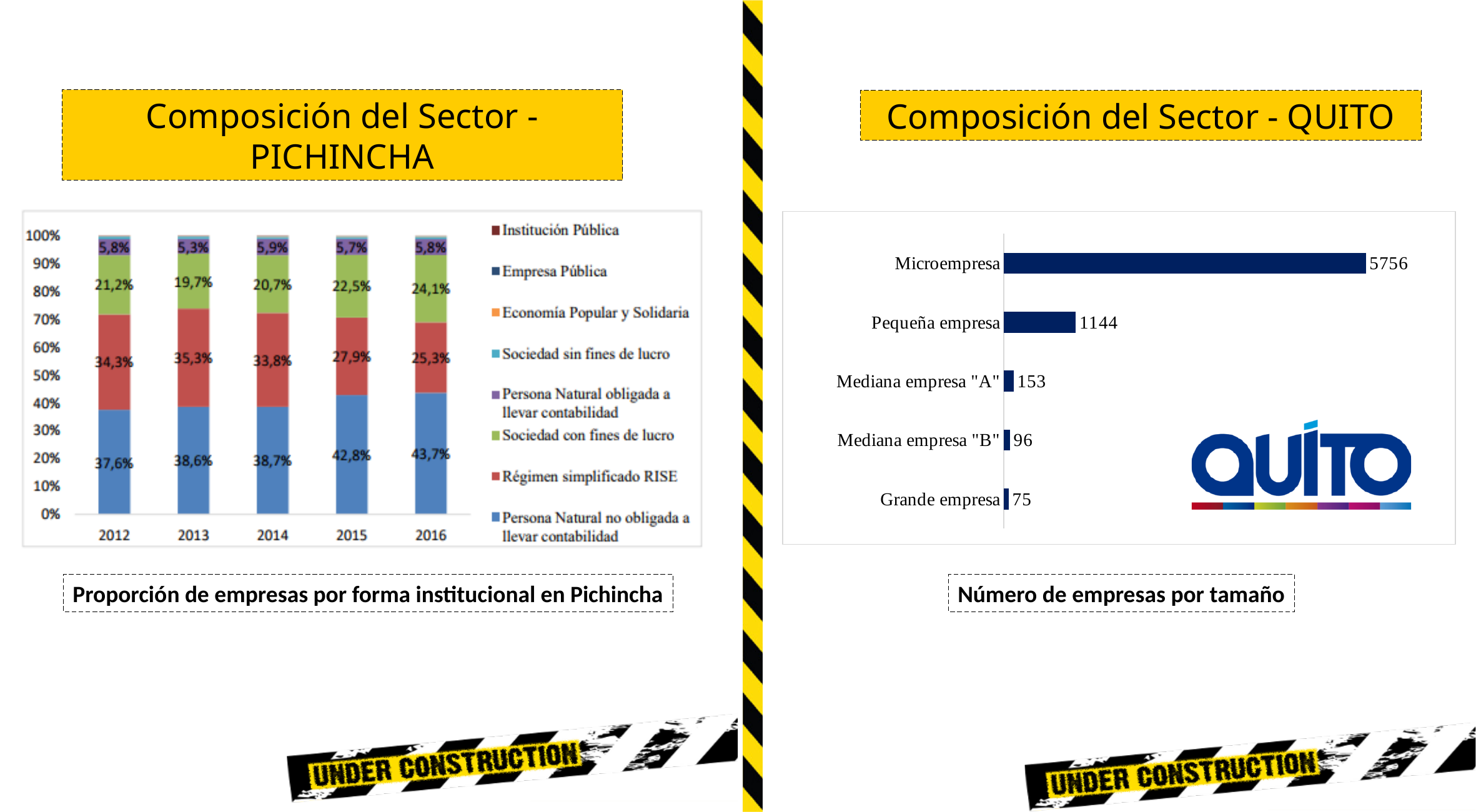
In the right-hand chart 'Número de empresas por tamaño', which category has the lowest value? Grande empresa In the left-hand chart 'Proporción de empresas por forma institucional en Pichincha', how many series does the legend list? 8 In the right-hand chart 'Número de empresas por tamaño', how many categories are shown? 5 In the left-hand chart 'Proporción de empresas por forma institucional en Pichincha', what is the share of Régimen simplificado RISE in 2013? 35,3% In the left-hand chart 'Proporción de empresas por forma institucional en Pichincha', what is the share of Persona Natural no obligada a llevar contabilidad in 2016? 43,7% In the left-hand chart 'Proporción de empresas por forma institucional en Pichincha', does the Régimen simplificado RISE share rise or fall from 2014 to 2016? Fall What kind of chart is the right-hand chart 'Número de empresas por tamaño'? Bar chart In the left-hand chart 'Proporción de empresas por forma institucional en Pichincha', in which year is the Sociedad con fines de lucro share highest? 2016 In the right-hand chart 'Número de empresas por tamaño', what is the value for Microempresa? 5756 In the right-hand chart 'Número de empresas por tamaño', what is the value for Pequeña empresa? 1144 In the right-hand chart 'Número de empresas por tamaño', what is the difference between Mediana empresa "A" and Mediana empresa "B"? 57 In the left-hand chart 'Proporción de empresas por forma institucional en Pichincha', which is larger in 2015: Persona Natural no obligada a llevar contabilidad or Régimen simplificado RISE? Persona Natural no obligada a llevar contabilidad